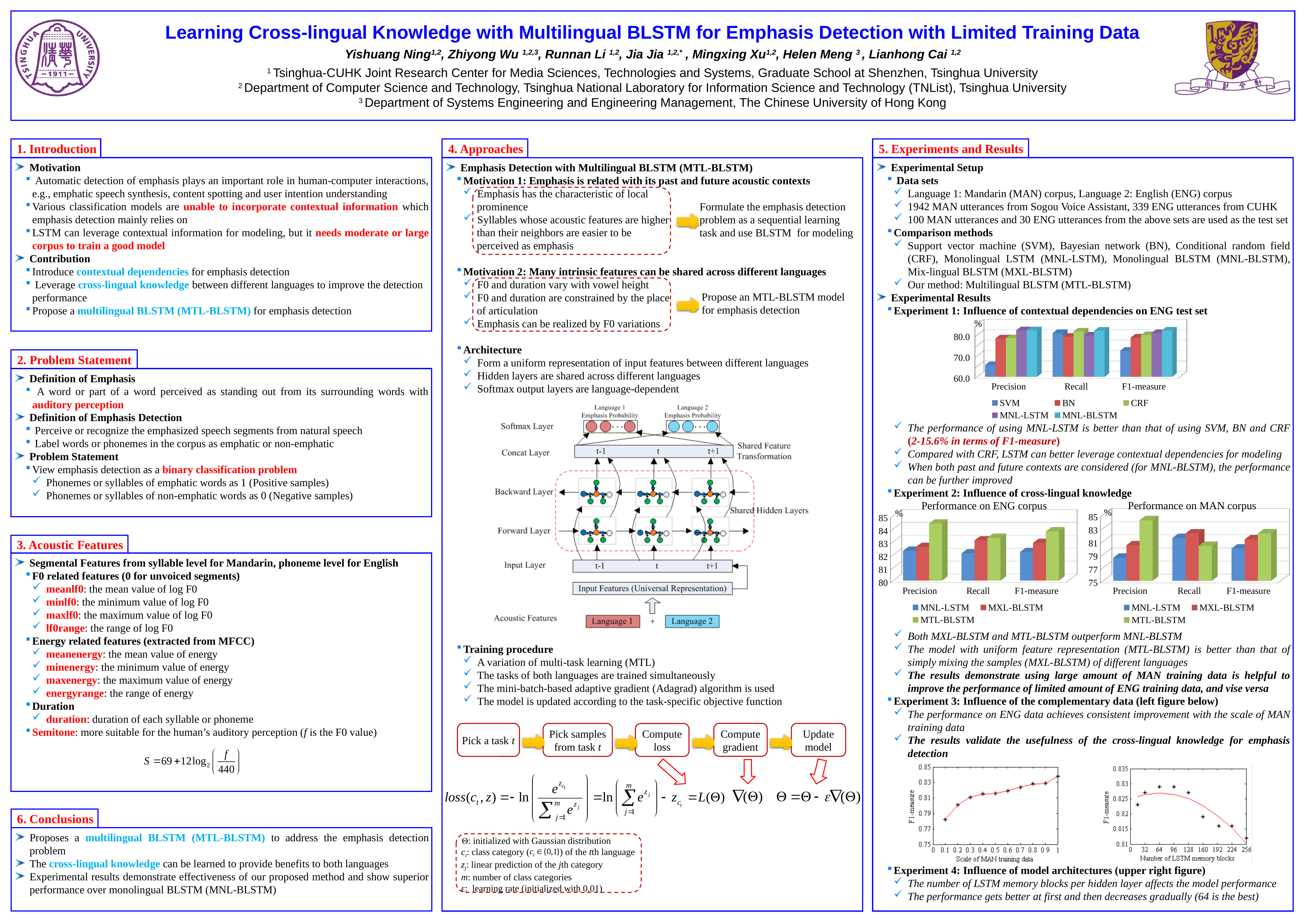
In the 'Performance on ENG corpus' chart, is the Precision value for MTL-BLSTM greater or less than 84? greater In the 'Performance on MAN corpus' chart, which is larger: the Recall of MXL-BLSTM or the Recall of MTL-BLSTM? MXL-BLSTM In the Experiment 1 chart (Influence of contextual dependencies on ENG test set), is the F1-measure value for SVM greater or less than 80.0? less In the Experiment 1 chart (Influence of contextual dependencies on ENG test set), how many series does the legend list? 5 In the Experiment 3 chart (F1-measure vs Scale of MAN training data), do the values rise or fall as the scale of MAN training data increases? rise In the Experiment 1 chart (Influence of contextual dependencies on ENG test set), is the Precision value for SVM greater or less than 70.0? less In the 'Performance on MAN corpus' chart, which series has the highest Precision? MTL-BLSTM What kind of chart is the Experiment 3 figure showing F1-measure against Scale of MAN training data? line chart In the 'Performance on ENG corpus' chart, which series has the highest Precision? MTL-BLSTM In the 'Performance on ENG corpus' chart, which series has the lowest Recall? MNL-LSTM In the Experiment 1 chart (Influence of contextual dependencies on ENG test set), which series has the lowest Precision? SVM